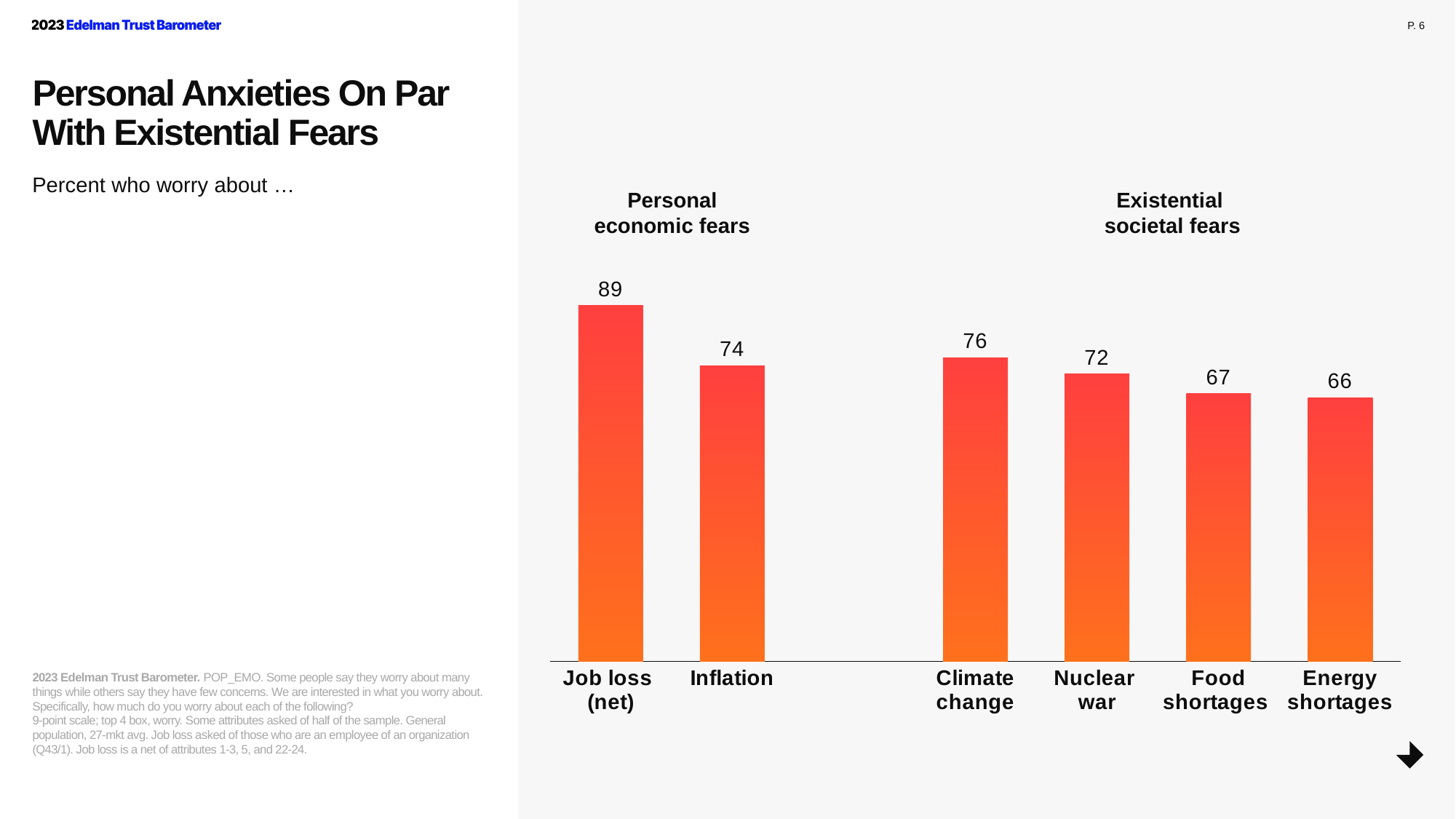
What is the difference between the values for Job loss (net) and Inflation? 15 Which category has the lowest value? Energy shortages What is the value for Climate change? 76 Which category has the highest value? Job loss (net) What is the value for Job loss (net)? 89 What is the difference between the values for Climate change and Food shortages? 9 What is the value for Nuclear war? 72 What is the value for Energy shortages? 66 Which is larger, the value for Inflation or the value for Nuclear war? Inflation What is the value for Inflation? 74 What kind of chart is shown on the slide? Bar chart How many categories are shown in the chart? 6